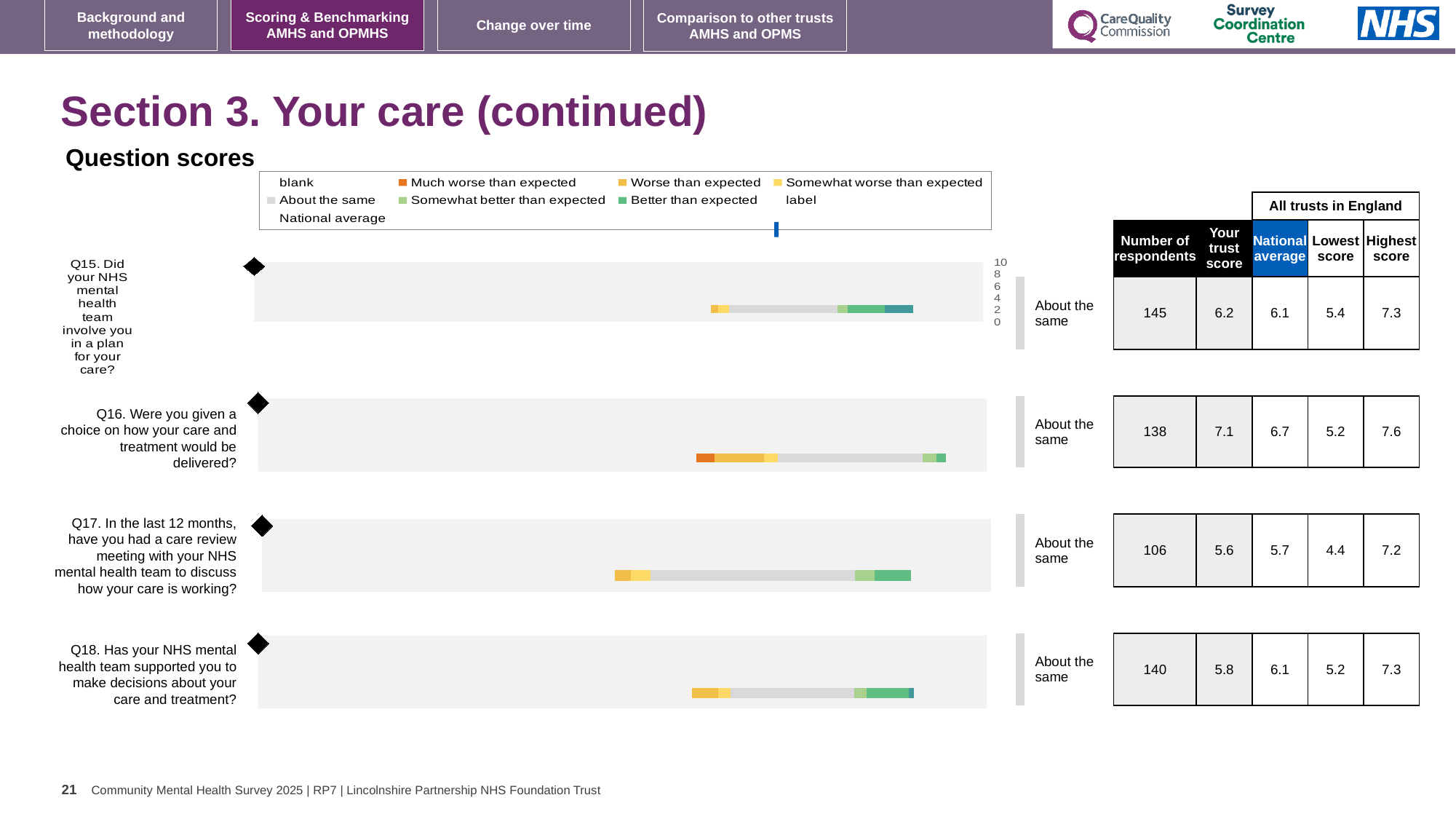
What kind of chart is used to show the question scores for Q15 to Q18? bar chart What colour is the legend marker for 'Much worse than expected'? orange What is the lowest score across all trusts in England for Q18? 5.2 Which question has the lowest number of respondents? Q17 For Q16, what is the difference between the highest score and the lowest score across all trusts in England? 2.4 What colour is the legend marker for 'About the same'? grey What is the number of respondents for Q15? 145 What is the benchmark label shown next to the Q18 bar chart? About the same Which question has the highest 'Your trust score'? Q16 What is the national average for Q17? 5.7 What is your trust score for Q16? 7.1 How many question bar charts (Q15 to Q18) are shown on the slide? 4